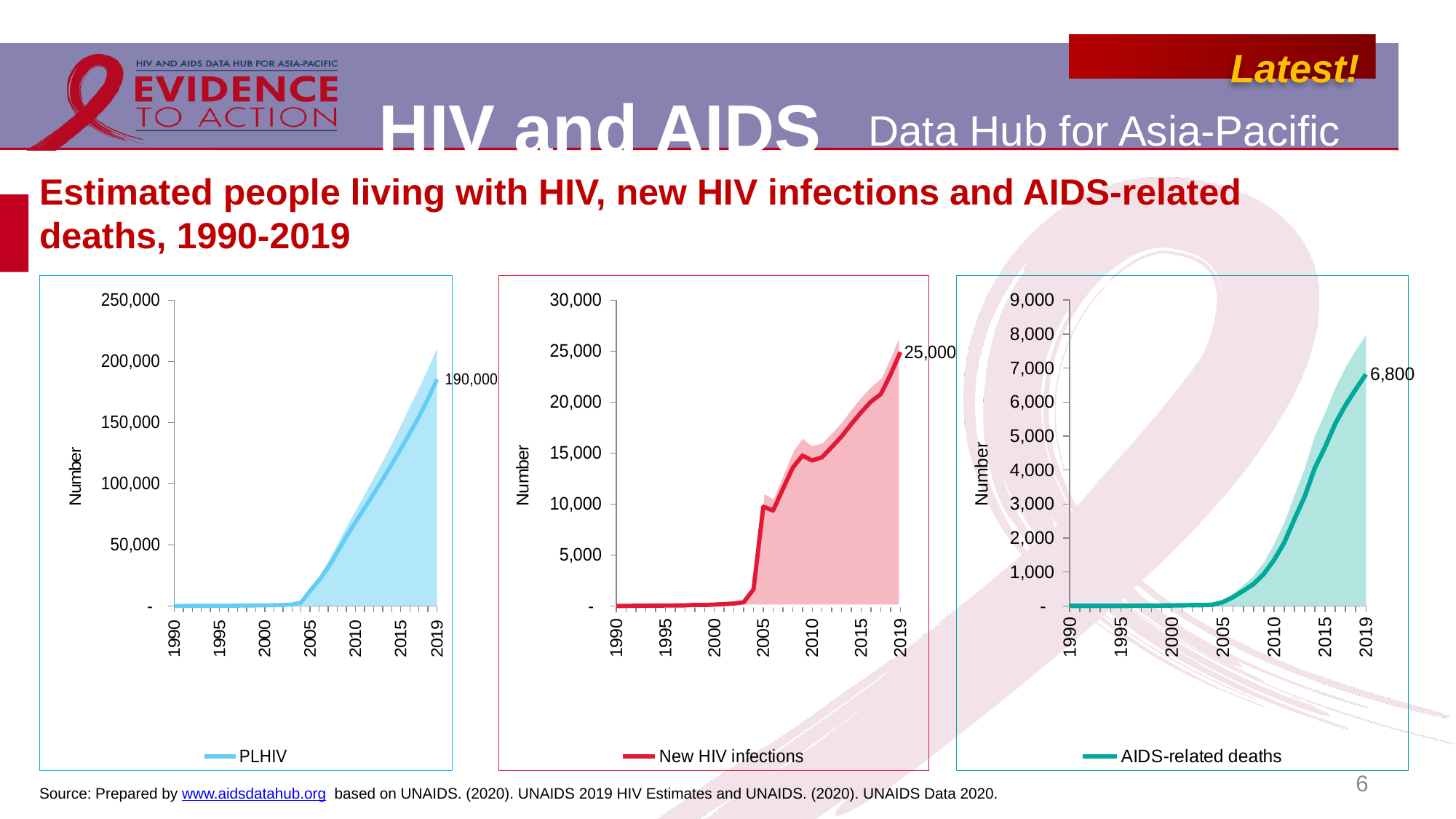
In the AIDS-related deaths chart, is the value for 2010 greater or less than 3,000? less In the New HIV infections chart, is the value for 2010 greater or less than 20,000? less What kind of chart is the PLHIV chart on the left? Line chart In the AIDS-related deaths chart on the right, what is the value shown for 2019? 6,800 In the PLHIV chart on the left, what is the value shown for 2019? 190,000 In the New HIV infections chart, do the values generally rise or fall from 1990 to 2019? Rise In the AIDS-related deaths chart, is the value for 2015 greater or less than 3,000? greater What is the legend entry of the chart on the right? AIDS-related deaths In the AIDS-related deaths chart, do the values generally rise or fall from 2005 to 2019? Rise In the New HIV infections chart in the middle, what is the value shown for 2019? 25,000 How many series does the legend of the middle chart list? 1